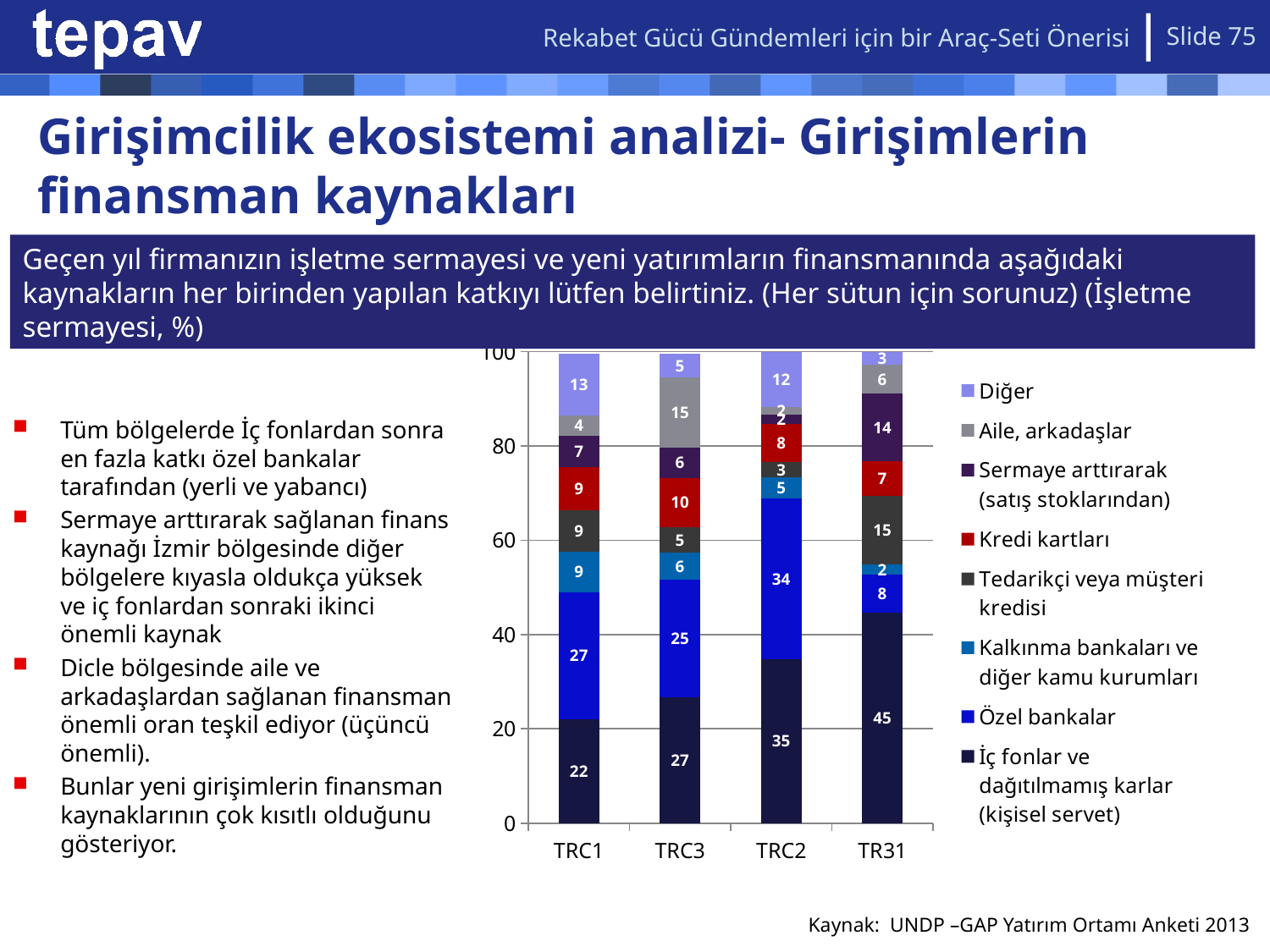
Which region has the highest value for İç fonlar ve dağıtılmamış karlar (kişisel servet)? TR31 What is the value of Aile, arkadaşlar for TRC3? 15 What is the value of Özel bankalar for TRC2? 34 What is the value of Diğer for TRC1? 13 How many regions are shown on the x axis? 4 What is the difference between the Özel bankalar values for TRC2 and TRC1? 7 Which region has the larger value for Sermaye arttırarak (satış stoklarından), TR31 or TRC1? TR31 What is the total of the stacked bar for TRC1? 100 How many series does the legend list? 8 Which region has the lowest value for Özel bankalar? TR31 What is the value of İç fonlar ve dağıtılmamış karlar (kişisel servet) for TR31? 45 What kind of chart is shown on the slide? Stacked bar chart